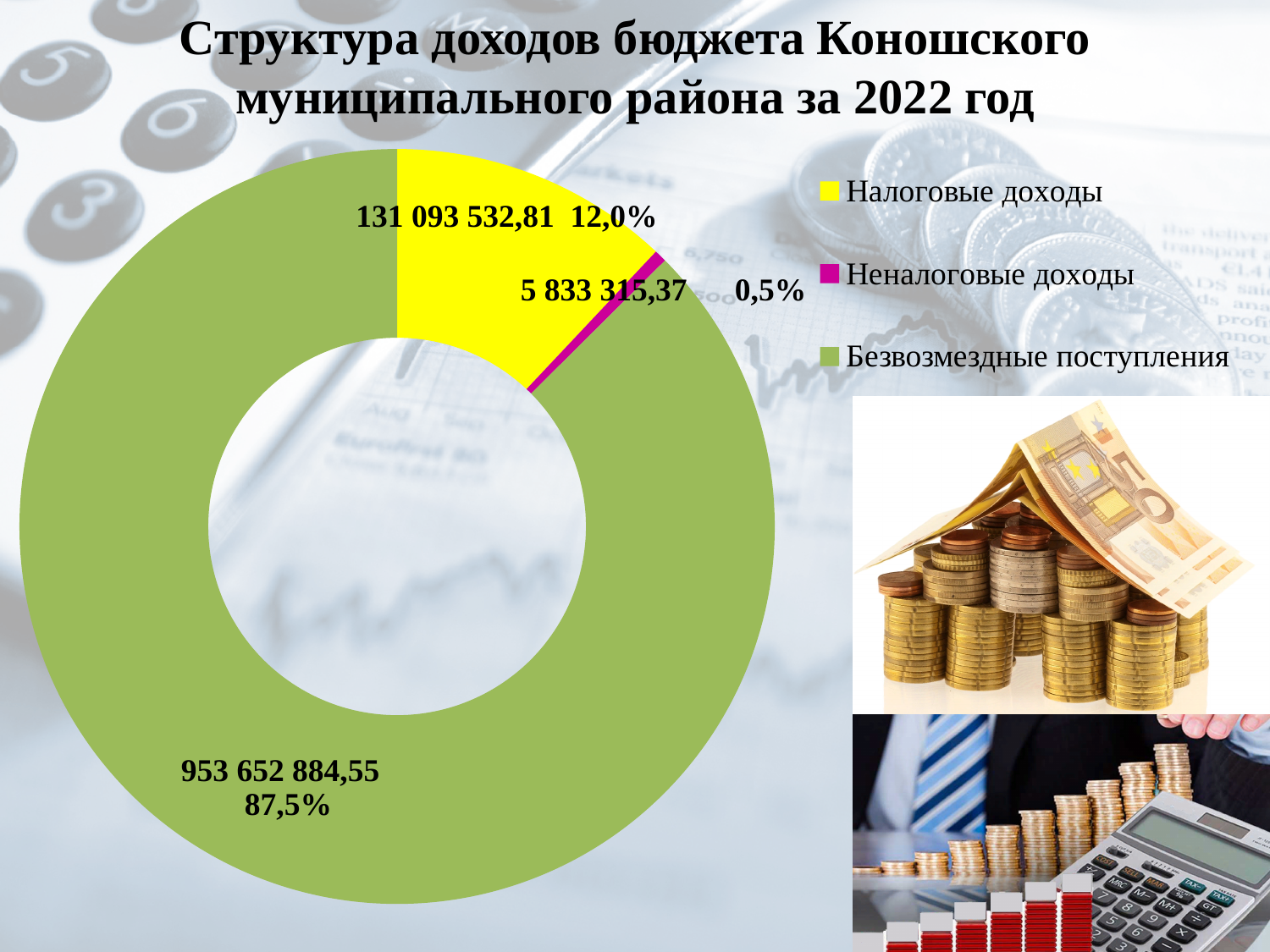
What share of the chart does Безвозмездные поступления represent? 87,5% Which category has the largest value? Безвозмездные поступления Which is larger, Налоговые доходы or Неналоговые доходы? Налоговые доходы Which category has the smallest value? Неналоговые доходы How many categories does the legend list? 3 What is the value shown for Безвозмездные поступления? 953 652 884,55 What is the value shown for Налоговые доходы? 131 093 532,81 What share of the chart does Неналоговые доходы represent? 0,5% What is the difference between the values for Безвозмездные поступления and Налоговые доходы? 822 559 351,74 What share of the chart does Налоговые доходы represent? 12,0% What kind of chart is shown on the slide? Doughnut (pie) chart What is the value shown for Неналоговые доходы? 5 833 315,37